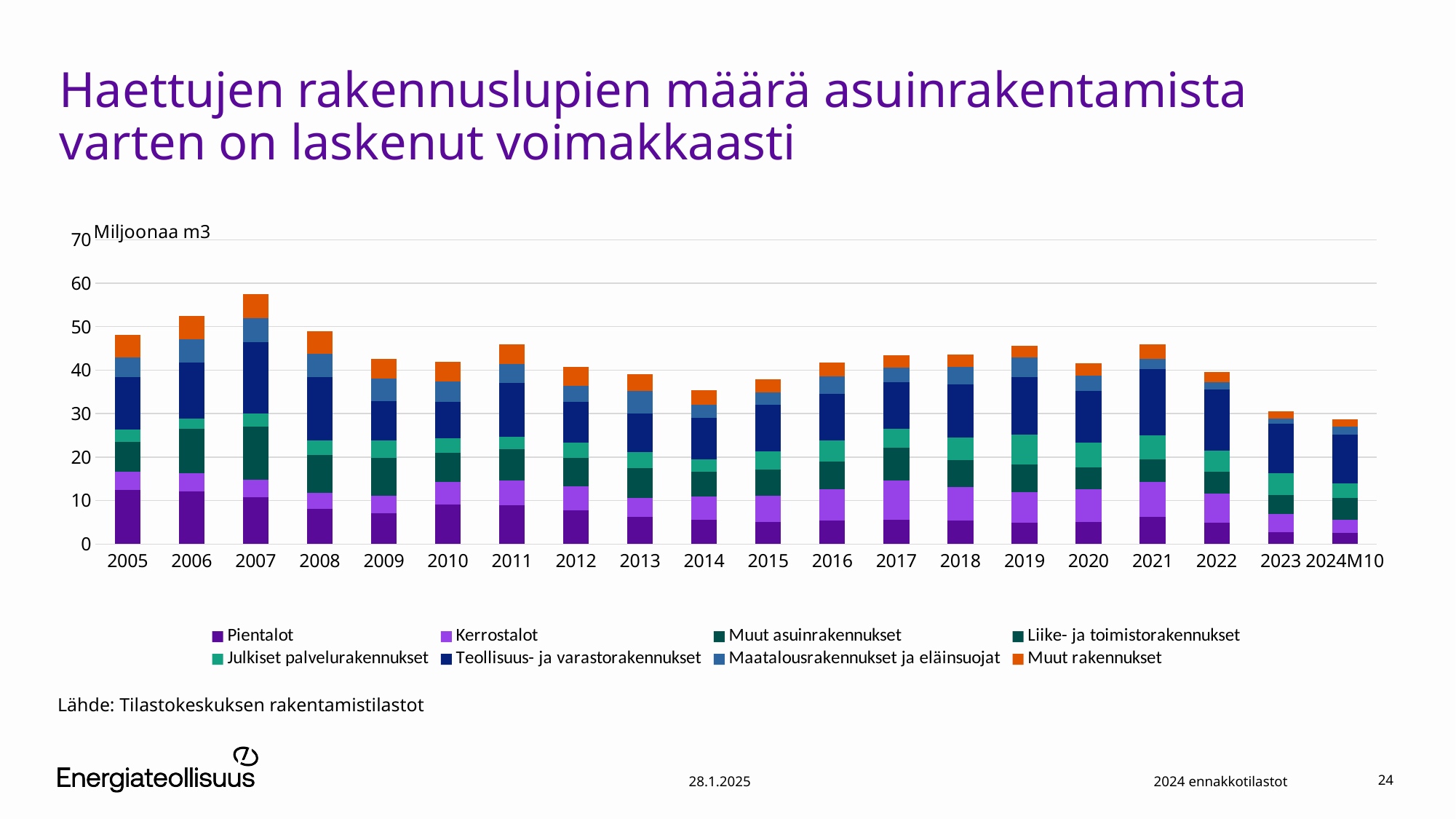
What unit is shown at the top of the y axis? Miljoonaa m3 Is the total for 2007 greater or less than 50? greater Which year has the highest total bar? 2007 Is the total for 2023 greater or less than 40? less Is the total for 2014 greater or less than 40? less How many years (categories) are shown on the x axis? 20 How many series does the legend list? 8 Which category has the lowest total bar? 2024M10 What kind of chart is shown on the slide? stacked bar chart Do the total bars generally rise or fall from 2005 to 2024M10? fall Which total bar is larger, 2006 or 2013? 2006